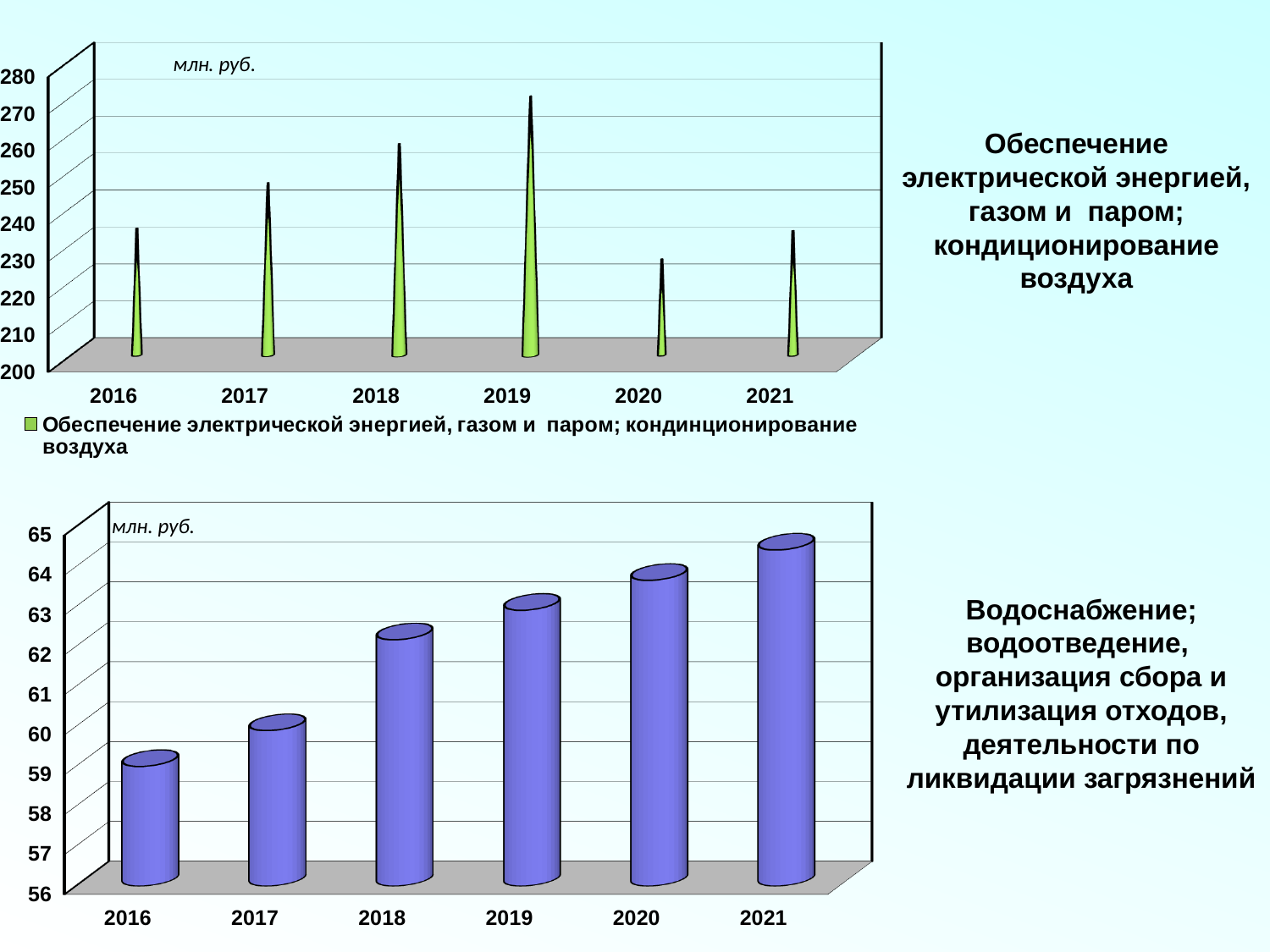
In the bottom chart, which year has the lowest value? 2016 In the top chart, which year has the lowest value? 2020 In the top chart, which year has the highest value? 2019 In the bottom chart, which year has the highest value? 2021 In the bottom chart, is the value for 2016 greater or less than 60? less In the top chart, how many years are shown on the x axis? 6 In the top chart, which is larger, the value for 2018 or the value for 2021? 2018 In the bottom chart, do the values rise or fall from 2016 to 2021? rise In the top chart, is the value for 2019 greater or less than 260? greater In the top chart, how many series does the legend list? 1 What kind of chart is the bottom chart? bar chart In the top chart, is the value for 2020 greater or less than 240? less